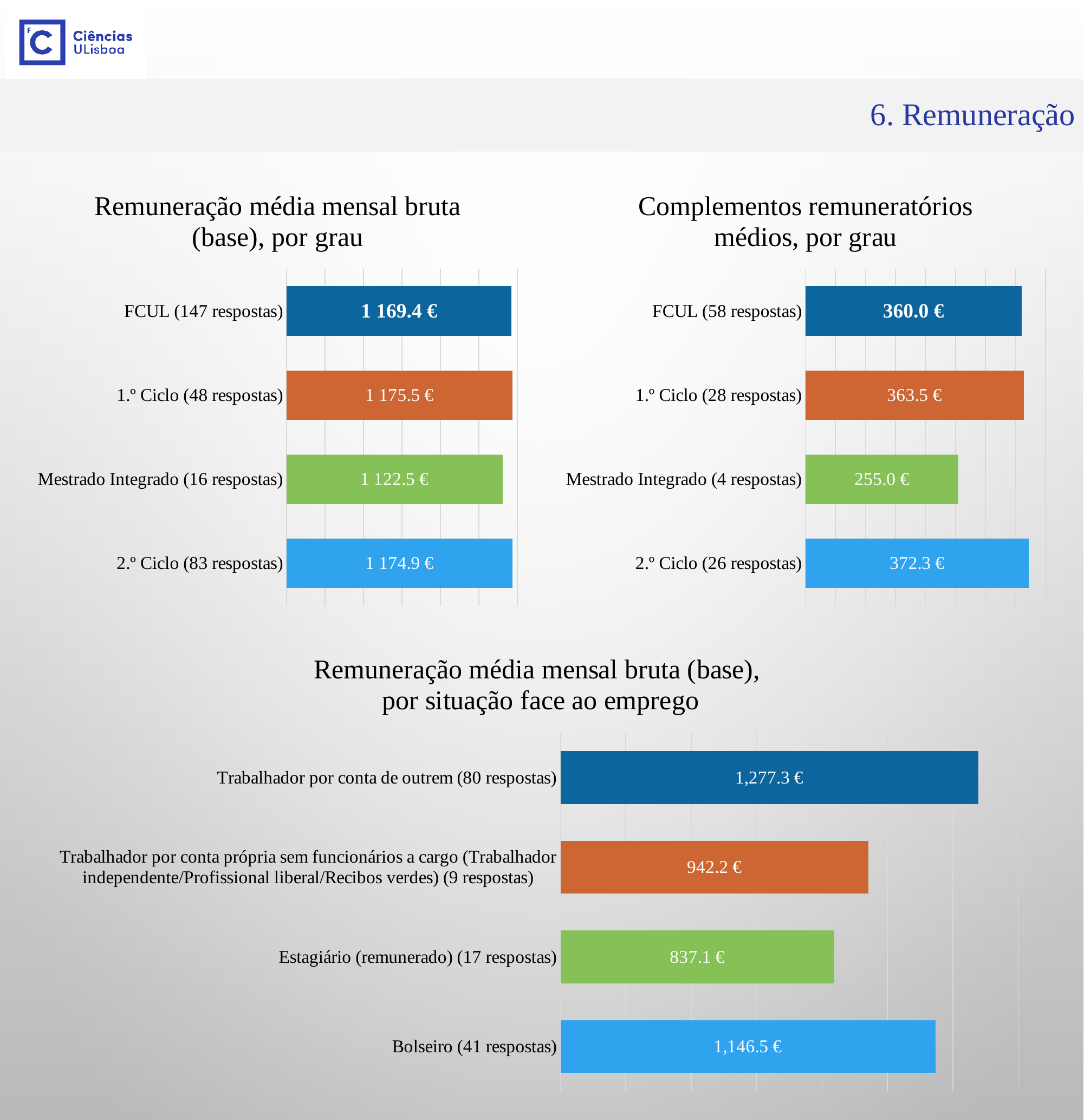
In the chart 'Complementos remuneratórios médios, por grau', which is larger: FCUL (58 respostas) or Mestrado Integrado (4 respostas)? FCUL (58 respostas) In the chart 'Complementos remuneratórios médios, por grau', what is the value for 2.º Ciclo (26 respostas)? 372.3 € In the chart 'Remuneração média mensal bruta (base), por grau', what is the value for FCUL (147 respostas)? 1 169.4 € In the chart 'Remuneração média mensal bruta (base), por situação face ao emprego', what is the value for Bolseiro (41 respostas)? 1,146.5 € In the chart 'Remuneração média mensal bruta (base), por situação face ao emprego', which category has the highest value? Trabalhador por conta de outrem (80 respostas) In the chart 'Remuneração média mensal bruta (base), por situação face ao emprego', which category has the lowest value? Estagiário (remunerado) (17 respostas) In the chart 'Complementos remuneratórios médios, por grau', which category has the lowest value? Mestrado Integrado (4 respostas) In the chart 'Remuneração média mensal bruta (base), por situação face ao emprego', what is the difference between Trabalhador por conta de outrem (80 respostas) and Estagiário (remunerado) (17 respostas)? 440.2 € In the chart 'Remuneração média mensal bruta (base), por grau', which category has the lowest value? Mestrado Integrado (16 respostas) In the chart 'Remuneração média mensal bruta (base), por grau', what is the difference between 1.º Ciclo (48 respostas) and Mestrado Integrado (16 respostas)? 53.0 € In the chart 'Complementos remuneratórios médios, por grau', what is the difference between 2.º Ciclo (26 respostas) and Mestrado Integrado (4 respostas)? 117.3 € How many categories are shown in the chart 'Remuneração média mensal bruta (base), por situação face ao emprego'? 4